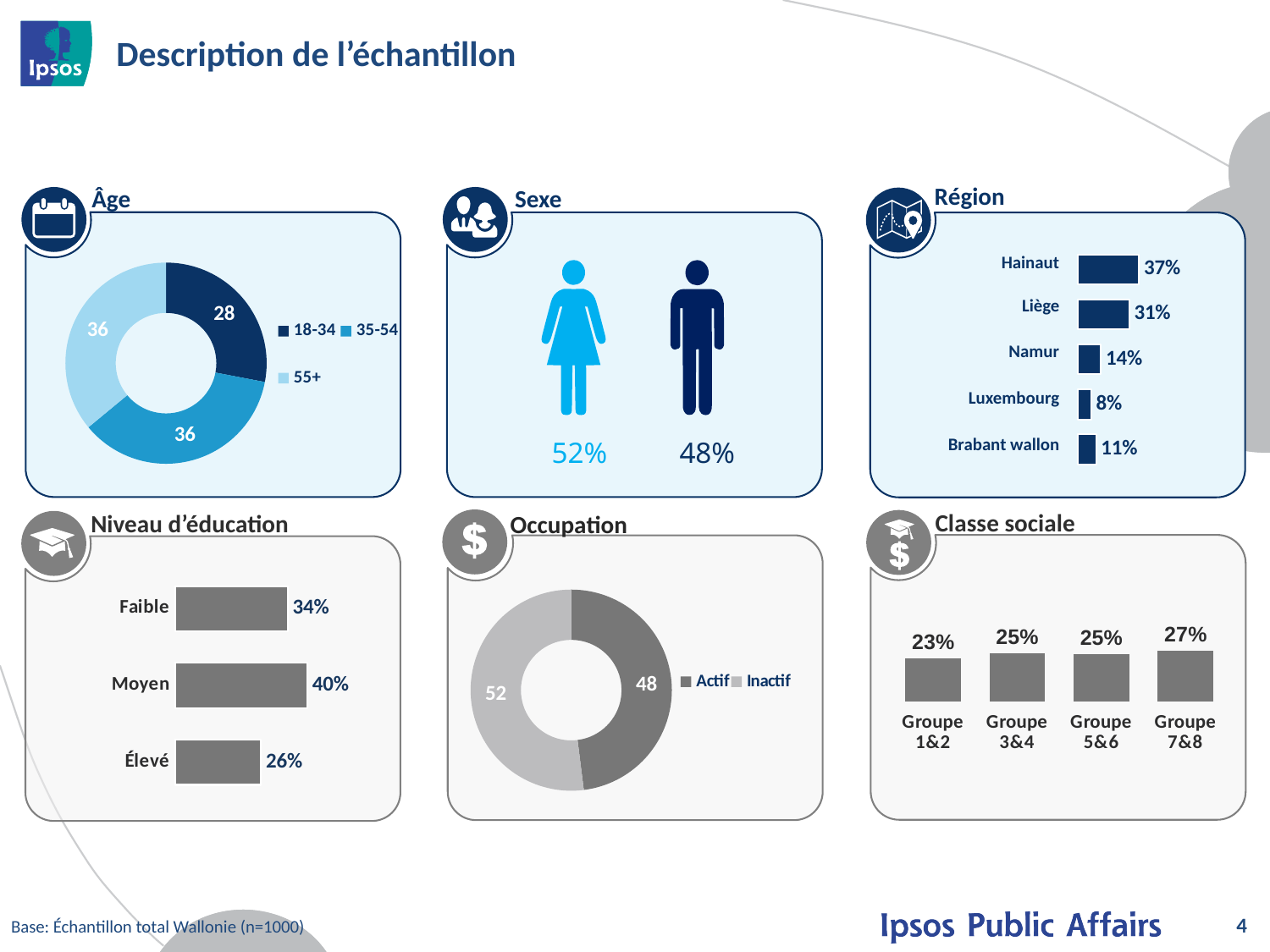
In the Région chart, which region has the lowest value? Luxembourg In the Âge chart, what is the value for the 18-34 segment? 28 In the Âge chart, how many entries does the legend list? 3 In the Région chart, what is the difference between Hainaut and Liège? 6% In the Classe sociale chart, do the values rise or fall from Groupe 1&2 to Groupe 7&8? Rise In the Région chart, what is the value for Hainaut? 37% In the Niveau d'éducation chart, which category has the highest value? Moyen In the Niveau d'éducation chart, what is the value for Élevé? 26% In the Région chart, how many regions are shown? 5 In the Niveau d'éducation chart, what kind of chart is used? Bar chart In the Occupation chart, which is larger, Actif or Inactif? Inactif In the Classe sociale chart, what is the value for Groupe 7&8? 27%